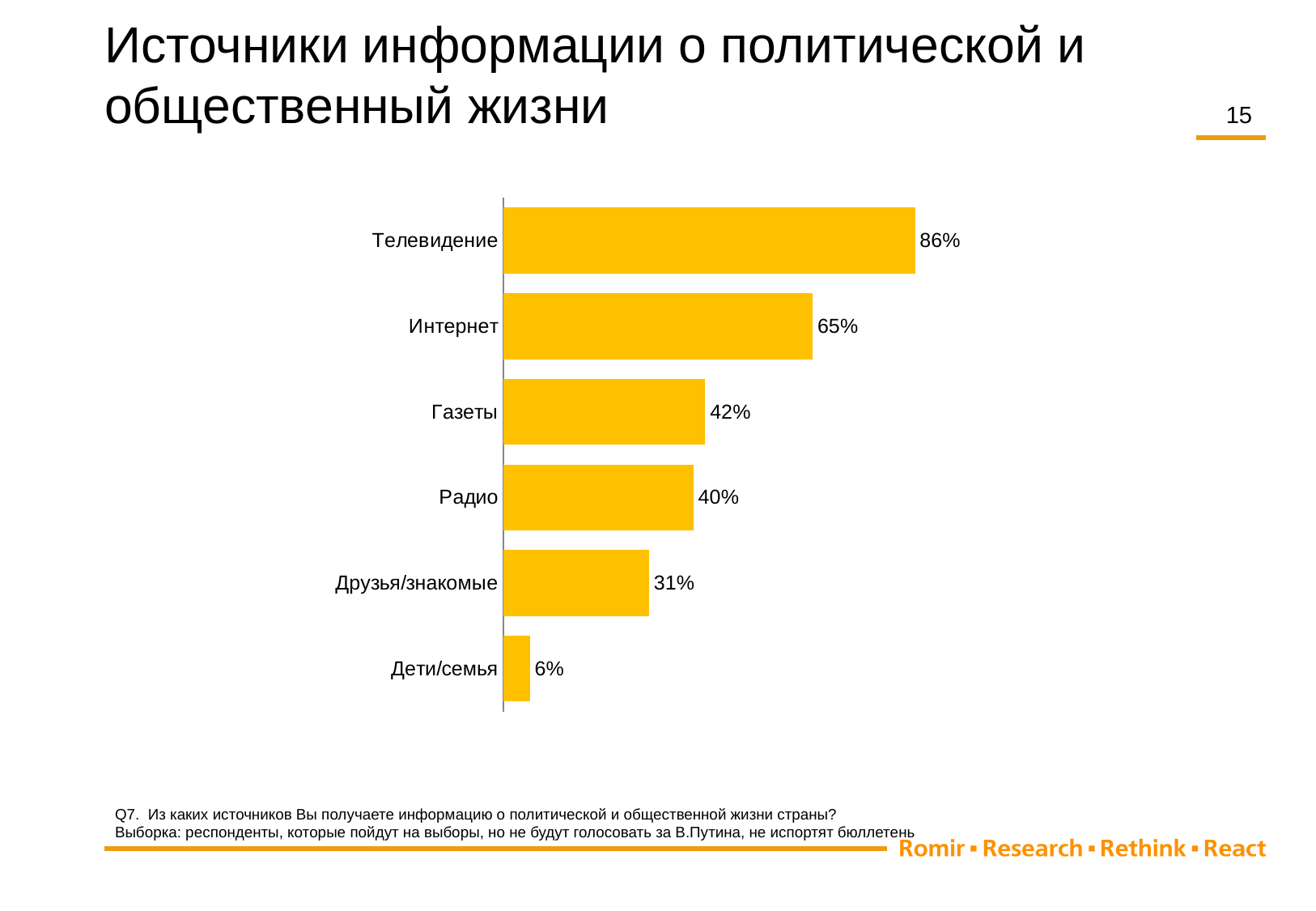
Which category has the highest value? Телевидение Which category has the lowest value? Дети/семья What is the value for Телевидение? 86% Which is larger, the value for Интернет or the value for Газеты? Интернет What is the value for Дети/семья? 6% What is the difference between the values for Телевидение and Интернет? 21% What colour are the bars in the chart? Yellow What is the difference between the values for Газеты and Друзья/знакомые? 11% What is the value for Радио? 40% What is the value for Интернет? 65% How many categories are shown in the chart? 6 What kind of chart is shown on the slide? Bar chart